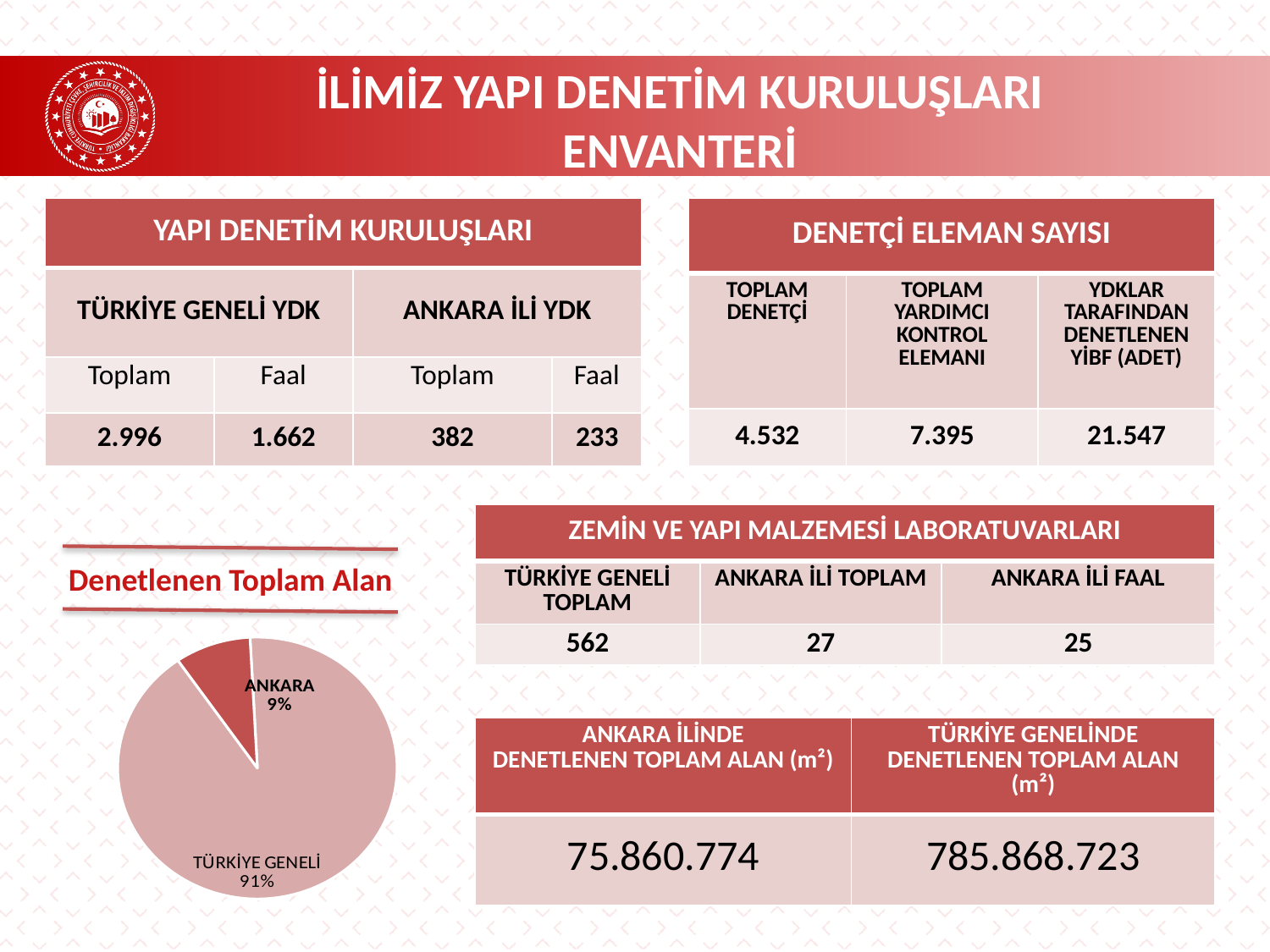
Is the ANKARA share in the pie chart greater or less than 10%? less Is the TÜRKİYE GENELİ share in the pie chart greater or less than 90%? greater In the pie chart, what share does ANKARA have? 9% In the pie chart, what share does TÜRKİYE GENELİ have? 91% Which slice of the pie chart is the smallest? ANKARA What kind of chart is shown under the title "Denetlenen Toplam Alan"? pie chart What are the labels of the two slices in the pie chart? ANKARA and TÜRKİYE GENELİ What is the difference in percentage points between the TÜRKİYE GENELİ slice and the ANKARA slice in the pie chart? 82 Which slice of the pie chart is the largest? TÜRKİYE GENELİ In the pie chart, which is larger: the ANKARA slice or the TÜRKİYE GENELİ slice? TÜRKİYE GENELİ What is the title of the pie chart on the slide? Denetlenen Toplam Alan How many slices does the pie chart have? 2